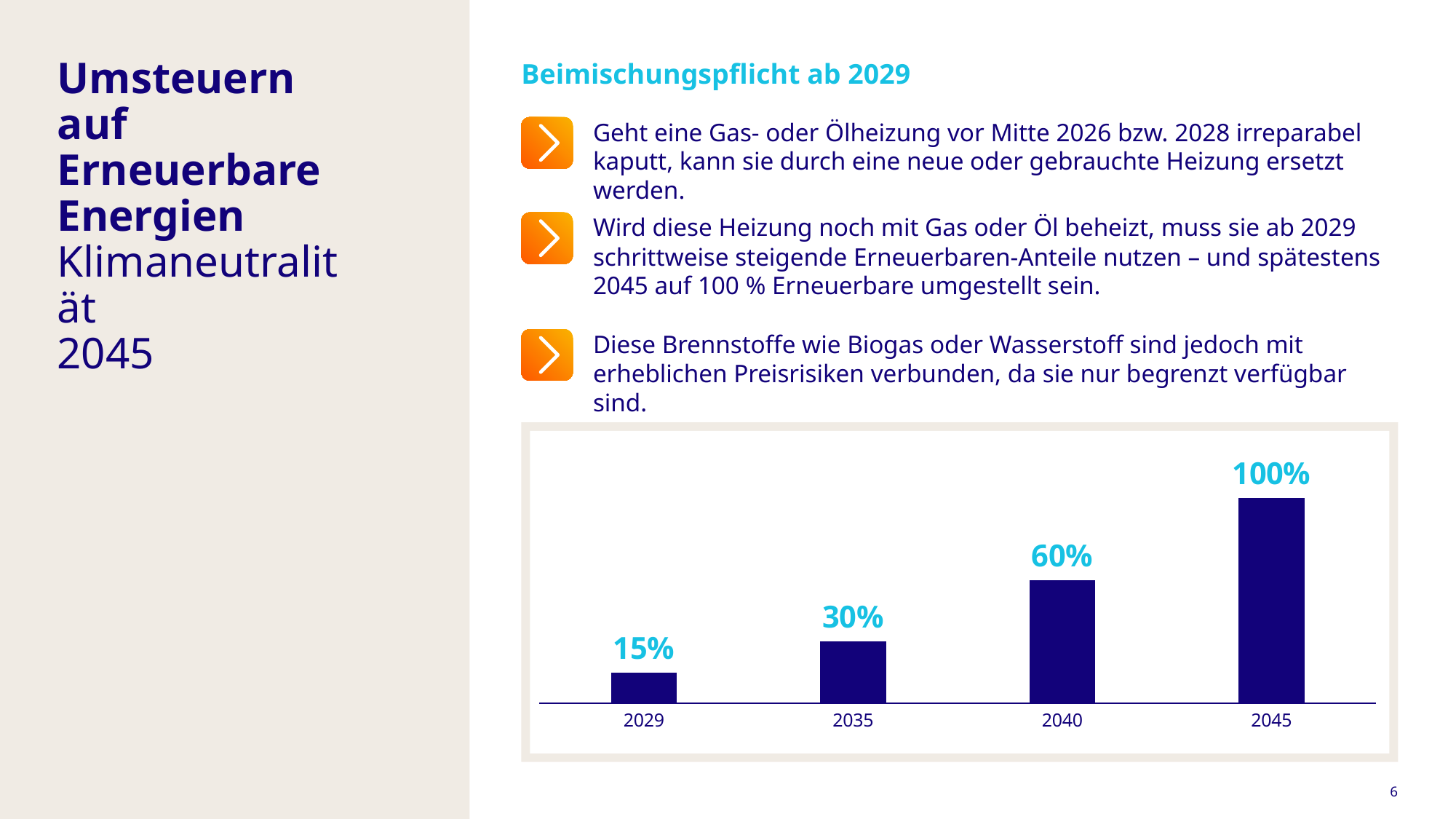
What is the value shown for 2029? 15% What is the value shown for 2040? 60% What is the value shown for 2045? 100% Do the values rise or fall from 2029 to 2045? Rise What is the difference between the values for 2045 and 2040? 40% How many years are shown on the x axis of the chart? 4 What is the value shown for 2035? 30% What kind of chart is shown on the slide? Bar chart Which is larger, the value for 2035 or the value for 2040? 2040 Which year has the highest value in the chart? 2045 Which year has the lowest value in the chart? 2029 What is the difference between the values for 2035 and 2029? 15%